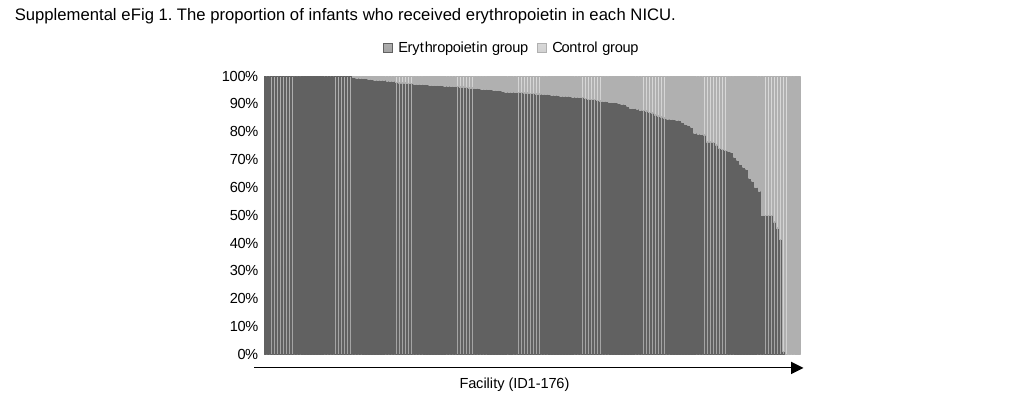
Does the proportion of the Control group rise or fall moving from left to right along the x axis? Rise What kind of chart is shown on the slide? Stacked bar chart Which group occupies the larger share of the leftmost bars, the Erythropoietin group or the Control group? Erythropoietin group How many series does the legend list? 2 What are the two groups listed in the legend? Erythropoietin group and Control group Is the Erythropoietin group share for the leftmost facility greater or less than 90%? greater Does the proportion of the Erythropoietin group rise or fall moving from left to right along the x axis? Fall What is the highest value shown on the y axis? 100% Which group occupies the larger share of the rightmost bars, the Erythropoietin group or the Control group? Control group How many facilities are plotted along the x axis, according to the axis label? 176 What is the label of the x axis? Facility (ID1-176) What does each stacked bar total? 100%